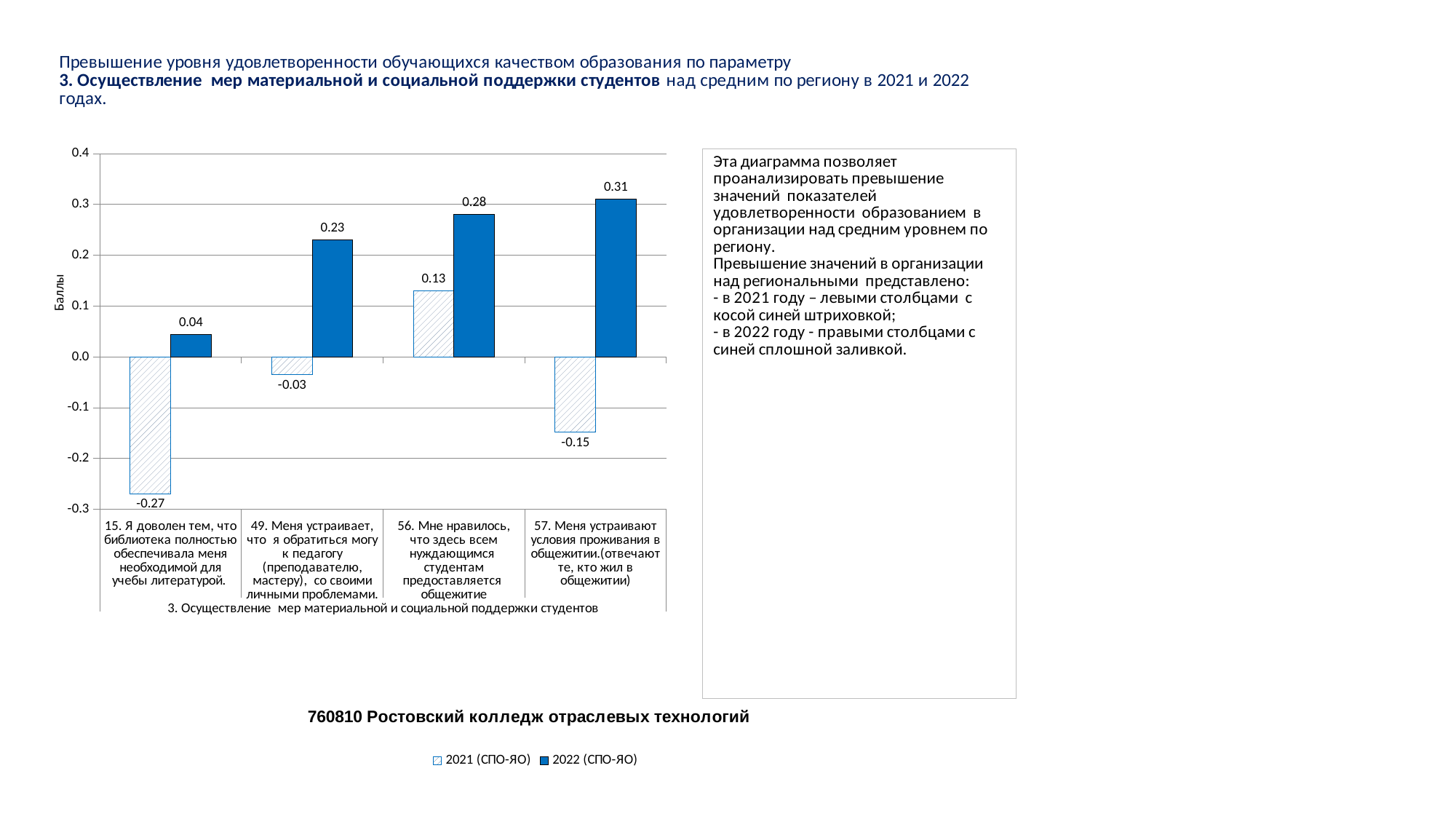
What is the label of the y axis? Баллы How many series does the legend list? 2 What is the 2022 (СПО-ЯО) value for category 15 (library literature)? 0.04 What is the difference between the 2022 and 2021 values for category 15? 0.31 What is the 2021 (СПО-ЯО) value for category 57 (dormitory living conditions)? -0.15 What is the 2021 (СПО-ЯО) value for category 49 (approaching a teacher with personal problems)? -0.03 What is the difference between the 2022 and 2021 values for category 56? 0.15 For category 56, which series has the larger value, 2021 (СПО-ЯО) or 2022 (СПО-ЯО)? 2022 (СПО-ЯО) Which category has the highest 2022 (СПО-ЯО) value? 57. Меня устраивают условия проживания в общежитии Which category has the lowest 2021 (СПО-ЯО) value? 15. Я доволен тем, что библиотека полностью обеспечивала меня необходимой для учебы литературой How many categories (questions) are shown on the x axis? 4 What type of chart is shown on the slide? bar chart